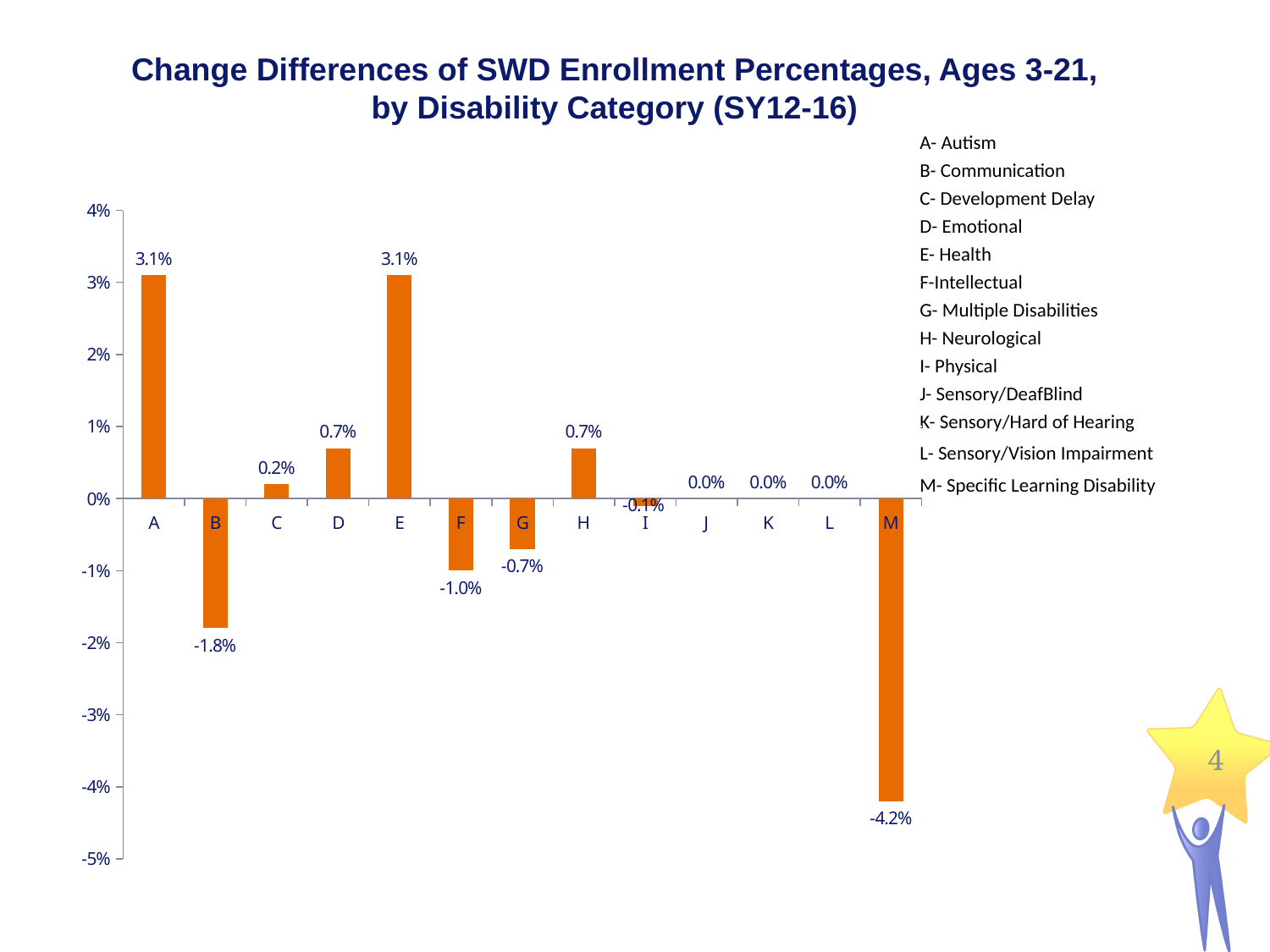
Which is larger, the value for category D or the value for category C? D What kind of chart is shown on the slide? Bar chart What is the difference between the values for category E and category H? 2.4% What is the value for category A (Autism)? 3.1% How many categories have a value of 0.0%? 3 Which category has the lowest value? M How many categories are shown on the x axis? 13 According to the key, what disability category does the letter G stand for? Multiple Disabilities What is the value for category F (Intellectual)? -1.0% What is the difference between the values for category A and category B? 4.9% What is the value for category B (Communication)? -1.8% What is the value for category M (Specific Learning Disability)? -4.2%